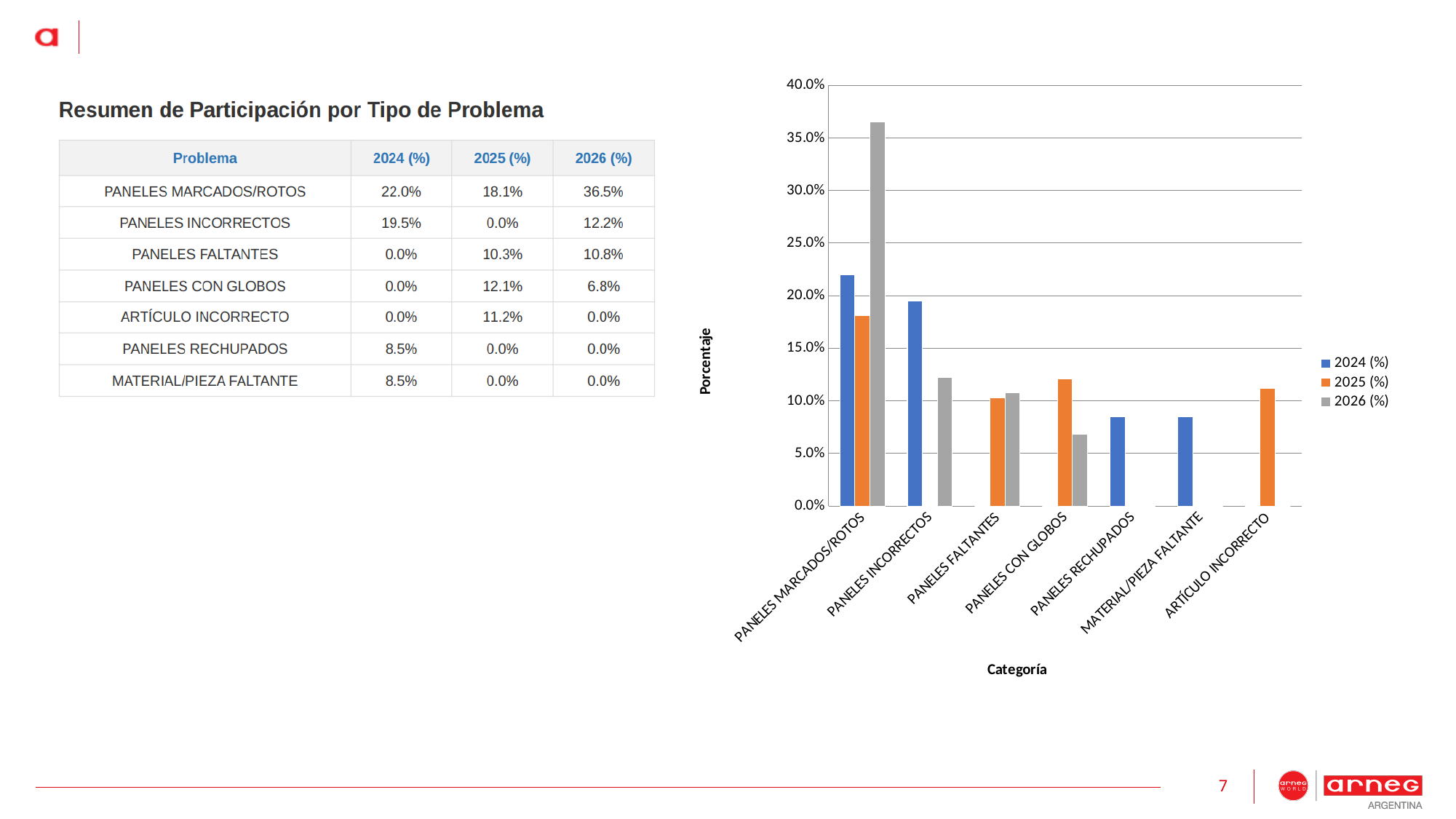
Which is larger for PANELES INCORRECTOS: the 2024 (%) value or the 2026 (%) value? 2024 (%) What kind of chart is shown on the slide? bar chart How many categories are shown on the x axis of the chart? 7 Is the 2024 (%) value for PANELES RECHUPADOS greater or less than 10.0%? less Which series has the highest value for PANELES MARCADOS/ROTOS? 2026 (%) According to the slide, what is the 2026 (%) value for PANELES MARCADOS/ROTOS? 36.5% What is the label of the chart's y axis? Porcentaje Is the 2025 (%) value for PANELES CON GLOBOS greater or less than 10.0%? greater Is the 2026 (%) value for PANELES MARCADOS/ROTOS greater or less than 35.0%? greater Which category has the tallest bar in the chart? PANELES MARCADOS/ROTOS How many series does the chart legend list? 3 What colour represents the 2025 (%) series in the chart? orange